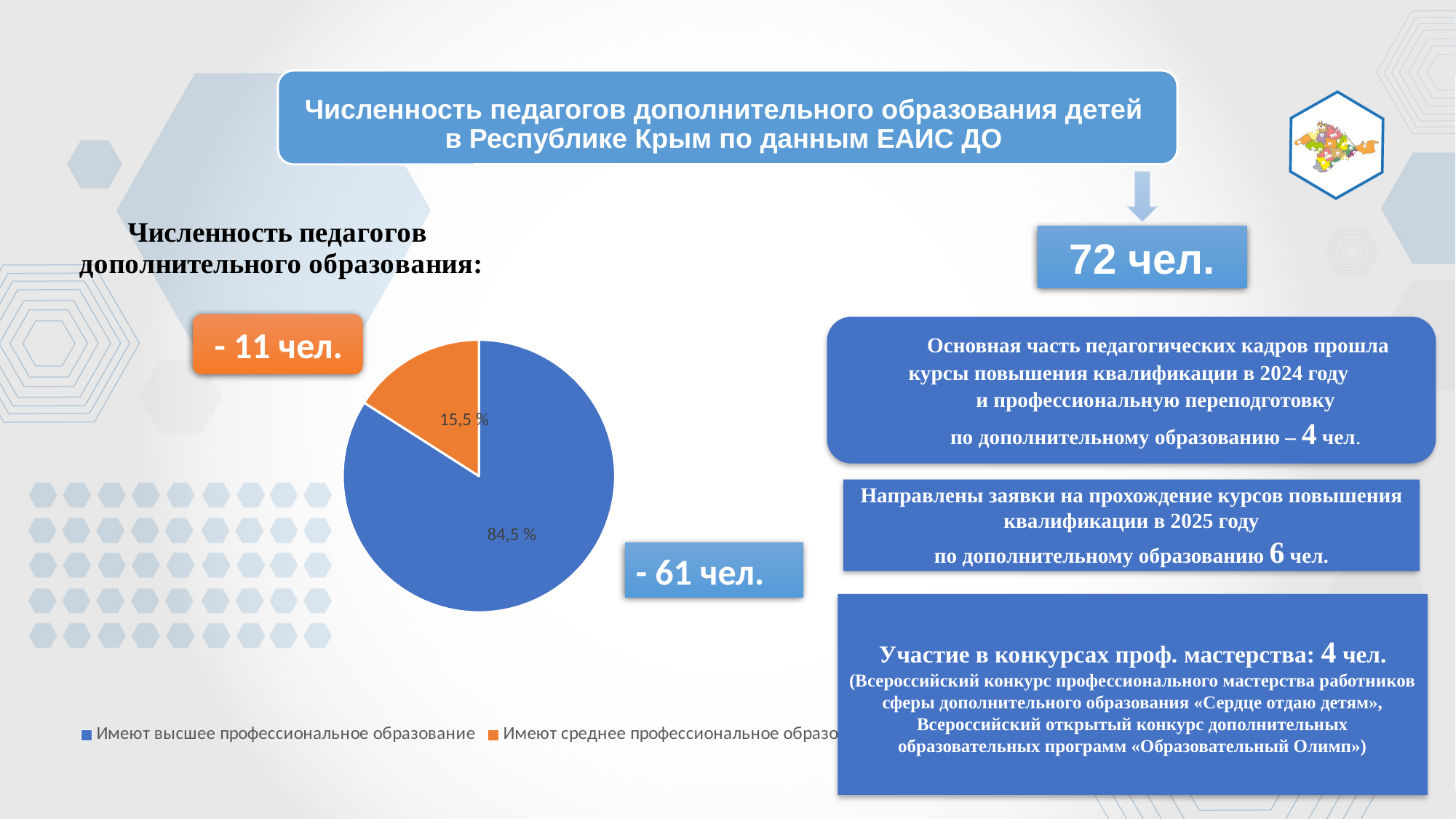
What kind of chart is shown on the slide? pie chart Is the share of the blue slice in the pie chart greater or less than 50%? greater Which slice of the pie chart is the smallest? Имеют среднее профессиональное образование What is the difference in percentage points between the two slices of the pie chart (84,5 % and 15,5 %)? 69 percentage points Which slice of the pie chart is the largest? Имеют высшее профессиональное образование What colour is the slice for "Имеют высшее профессиональное образование" in the pie chart? blue Which is larger in the pie chart: the share with higher professional education or the share with secondary professional education? higher professional education (Имеют высшее профессиональное образование) What share of the pie chart is labelled for the slice "Имеют высшее профессиональное образование"? 84,5 % What colour is the slice for "Имеют среднее профессиональное образование" in the pie chart? orange How many slices does the pie chart have? 2 How many entries does the legend of the pie chart list? 2 What share of the pie chart is labelled for the orange slice ("Имеют среднее профессиональное образование")? 15,5 %